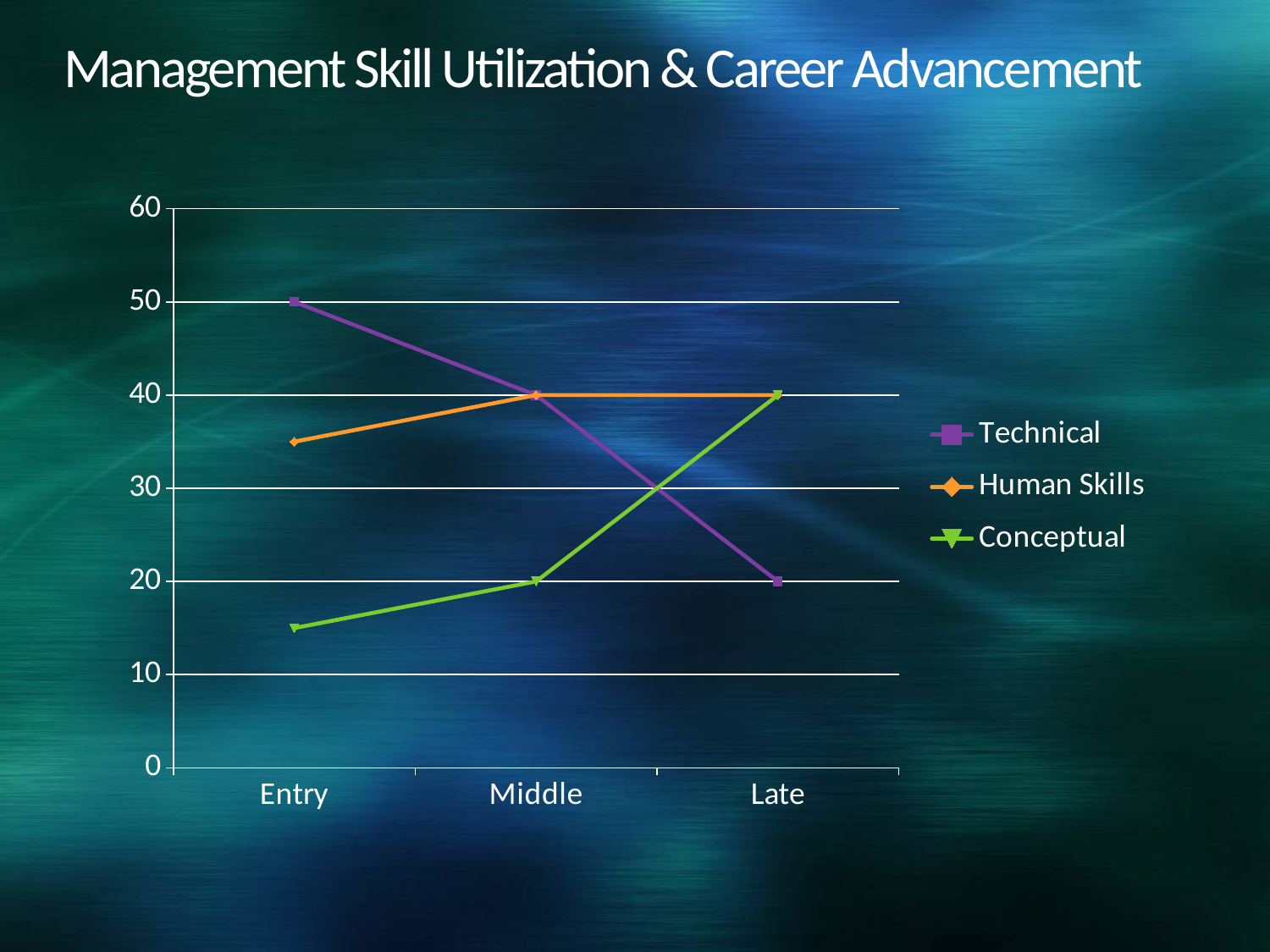
Which series has the highest value at the Entry stage? Technical What is the value for Technical at the Late stage? 20 Is the value for Conceptual at the Entry stage greater or less than 20? less How many series does the legend list? 3 What is the value for Conceptual at the Middle stage? 20 What is the value for Technical at the Entry stage? 50 What is the difference between the Technical value at Entry and the Technical value at Late? 30 What is the value for Human Skills at the Late stage? 40 Does the Technical series rise or fall from Entry to Late? Fall What kind of chart is shown on the slide? Line chart How many career stages are shown on the x axis? 3 Is the value for Human Skills at the Entry stage greater or less than 30? greater